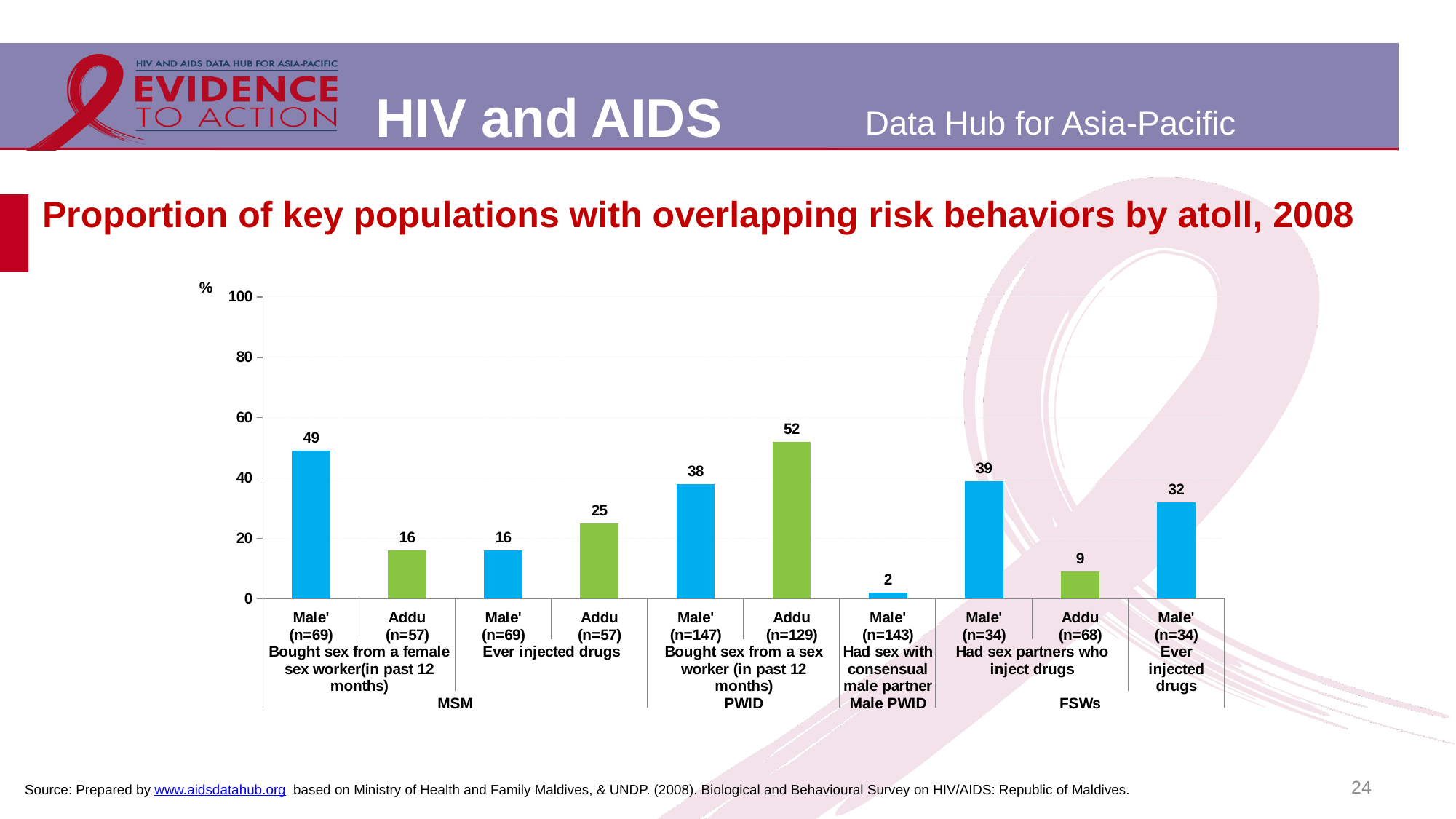
What kind of chart is shown on the slide? Bar chart Which bar has the highest value on the chart? Addu (n=129) PWID, bought sex from a sex worker (in past 12 months) What is the value for Addu (n=68) FSWs who had sex partners who inject drugs? 9 Which bar has the lowest value on the chart? Male' (n=143) Male PWID, had sex with consensual male partner How many bars are plotted on the chart? 10 What is the difference between the Male' and Addu values for FSWs who had sex partners who inject drugs? 30 What is the title of the chart? Proportion of key populations with overlapping risk behaviors by atoll, 2008 What is the value for Addu (n=129) PWID who bought sex from a sex worker in the past 12 months? 52 For MSM who ever injected drugs, which is larger: Male' or Addu? Addu What is the difference between the Addu and Male' values for PWID who bought sex from a sex worker in the past 12 months? 14 What is the value for Male' (n=143) Male PWID who had sex with a consensual male partner? 2 What is the value for Male' (n=69) MSM who bought sex from a female sex worker in the past 12 months? 49